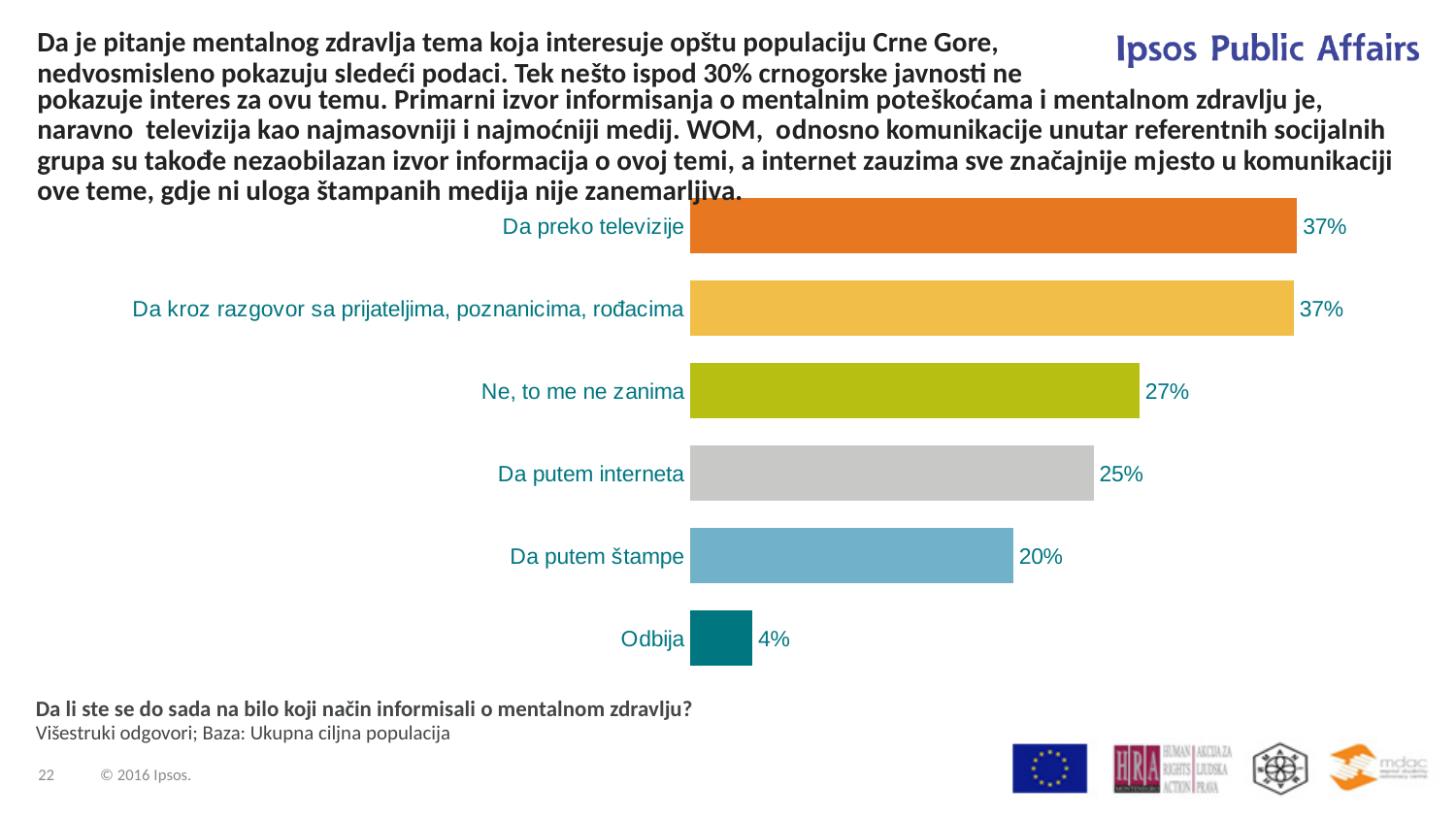
What colour is the bar for "Da preko televizije"? Orange What is the difference between the values for "Ne, to me ne zanima" and "Odbija"? 23% What is the value for "Da putem interneta"? 25% What is the value for "Da preko televizije"? 37% What is the value for "Da putem štampe"? 20% How many categories are shown in the chart? 6 What kind of chart is shown on the slide? Bar chart What is the value for "Ne, to me ne zanima"? 27% Which is larger, the value for "Da putem interneta" or the value for "Da putem štampe"? Da putem interneta What is the difference between the values for "Da preko televizije" and "Da putem štampe"? 17% Which category has the lowest value? Odbija What is the value for "Odbija"? 4%